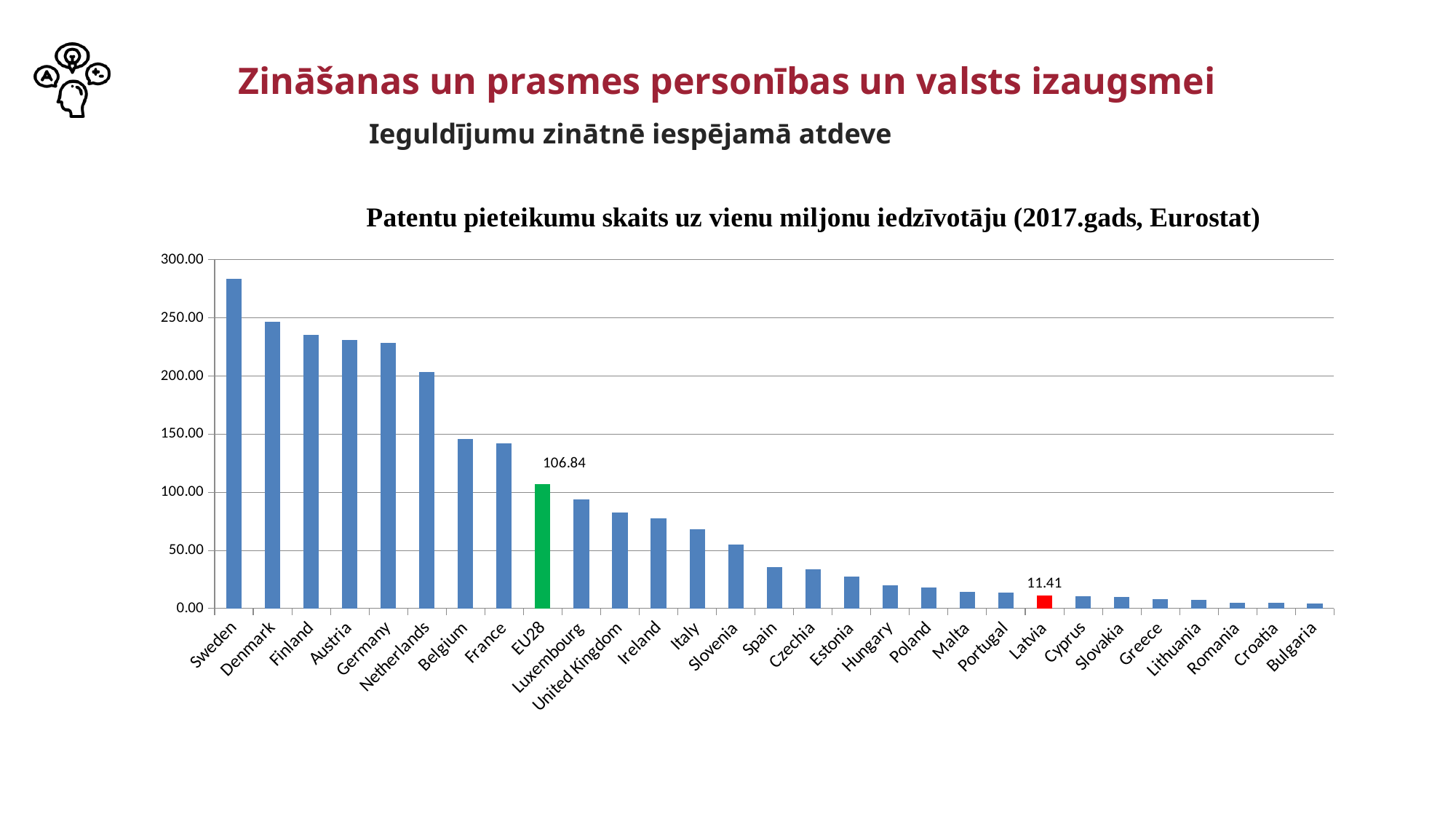
Is the value for Luxembourg greater or less than 100? less Is the value for Sweden greater or less than 250? greater Which has a larger value, Germany or Belgium? Germany How many categories are shown on the x axis? 29 What is the value for EU28? 106.84 What type of chart is shown on the slide? bar chart What is the difference between the values for EU28 and Latvia? 95.43 Do the values rise or fall from left to right along the x axis? fall What is the value for Latvia? 11.41 Which country has the highest number of patent applications per million inhabitants? Sweden Is the value for Spain greater or less than 50? less